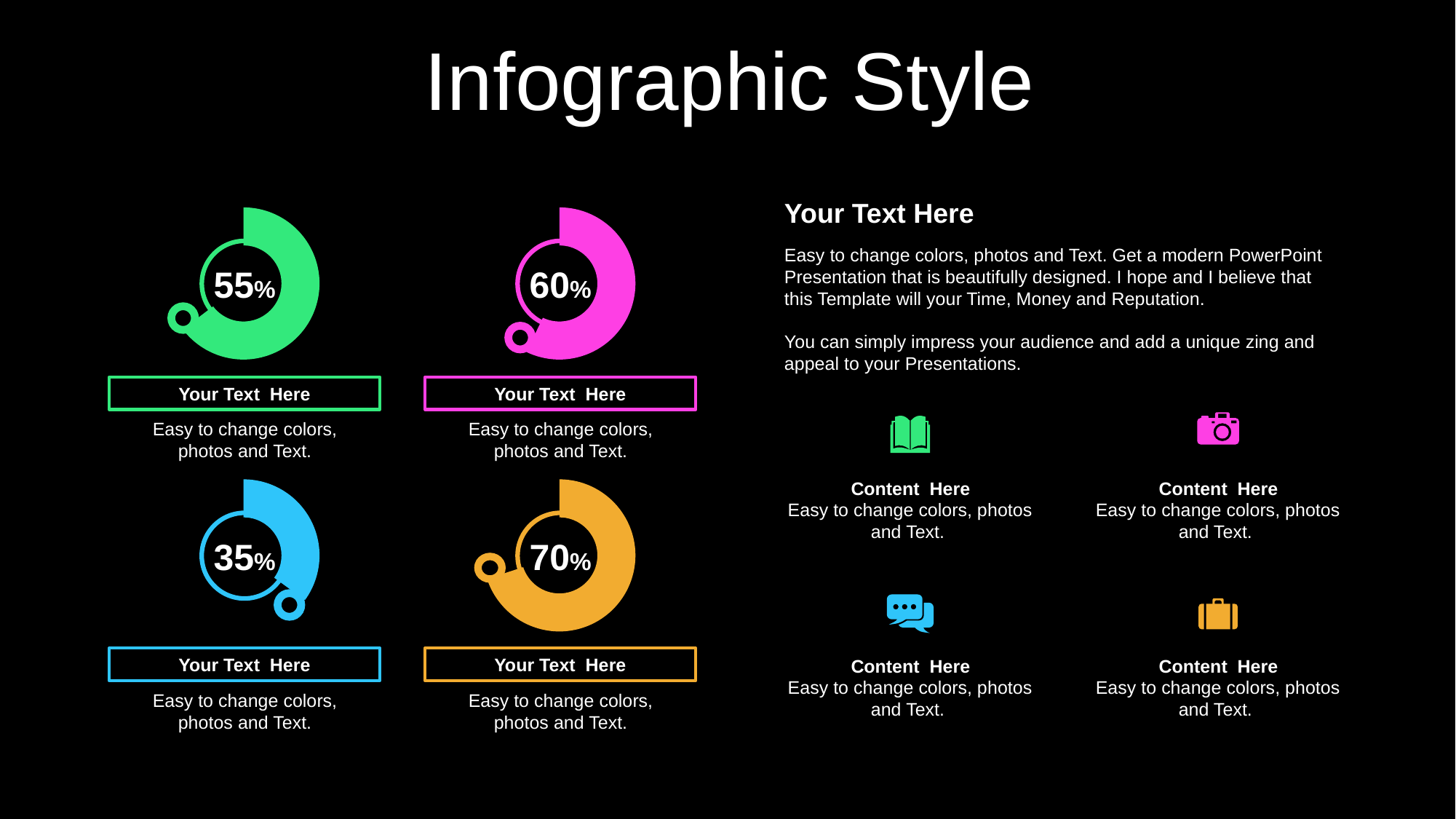
What is the difference between the value in the orange donut chart and the value in the blue donut chart? 35% What value is shown in the blue donut chart at the bottom left? 35% What value is shown in the magenta donut chart at the top right of the chart group? 60% What kind of charts are used to display the percentages on the slide? Donut charts What value is shown in the green donut chart at the top left? 55% What value is shown in the orange donut chart at the bottom right of the chart group? 70% Which of the four donut charts shows the highest percentage? The orange chart (70%) What is the difference between the value in the magenta donut chart and the value in the green donut chart? 5% Which is larger, the value in the green donut chart or the value in the blue donut chart? The green chart (55%) What is the title of the slide? Infographic Style How many donut charts are shown on the slide? 4 Which of the four donut charts shows the lowest percentage? The blue chart (35%)